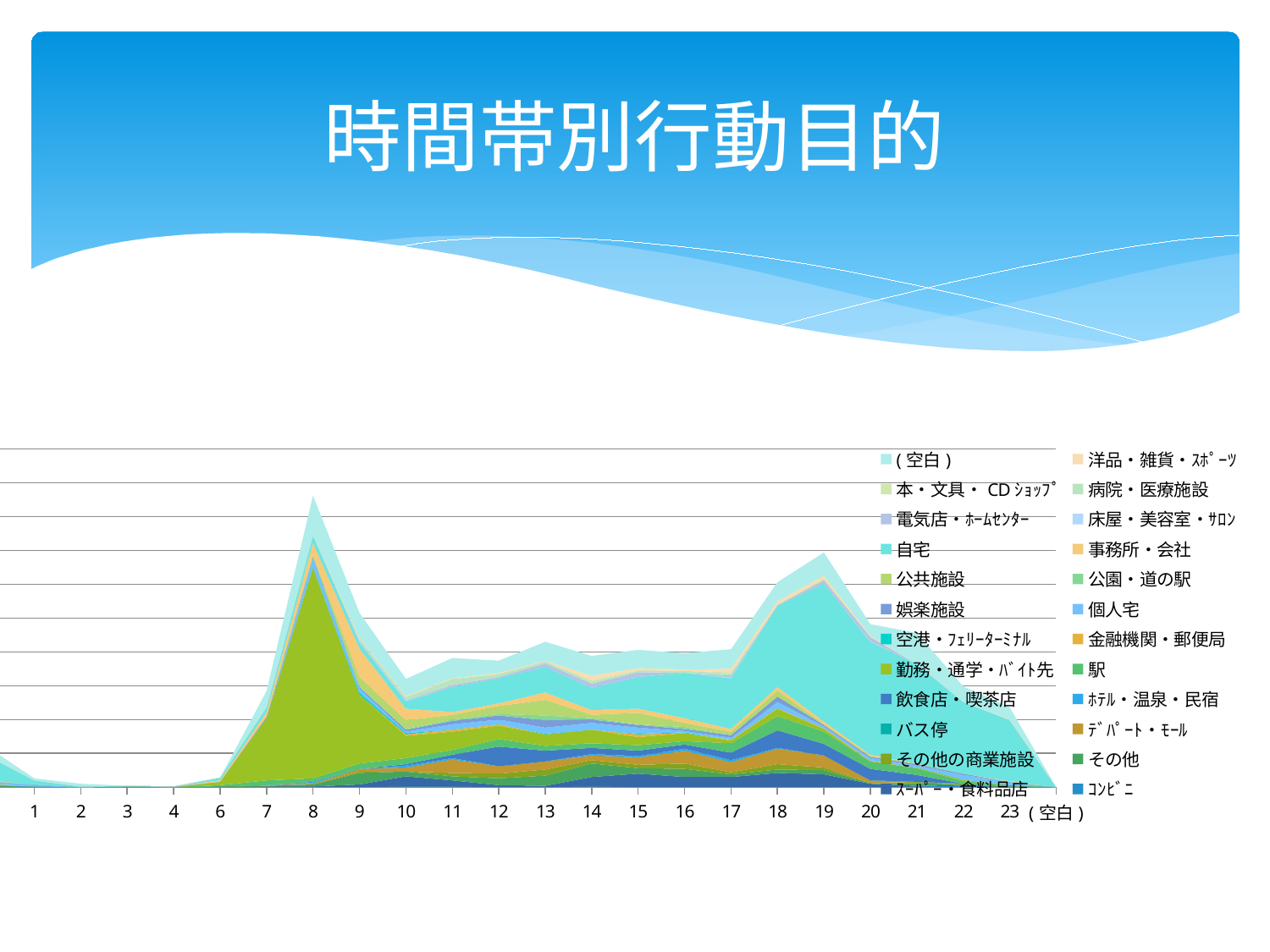
Which hour label is missing from the sequence on the x axis between 4 and 6? 5 Is the total stacked value larger at hour 8 or at hour 19? 8 Does the total stacked value rise or fall from hour 17 to hour 19? rise What kind of chart is shown on the slide? stacked area chart Is the total stacked value larger at hour 19 or at hour 23? 19 Which series makes up most of the stacked total at hour 8? 勤務・通学・ﾊﾞｲﾄ先 What is the title of the slide? 時間帯別行動目的 Is the total stacked value larger at hour 1 or at hour 3? 1 At which x-axis category does the total stacked value reach its highest point? 8 Does the total stacked value rise or fall from hour 8 to hour 10? fall How many series does the legend list? 24 How many categories are shown along the x axis? 23